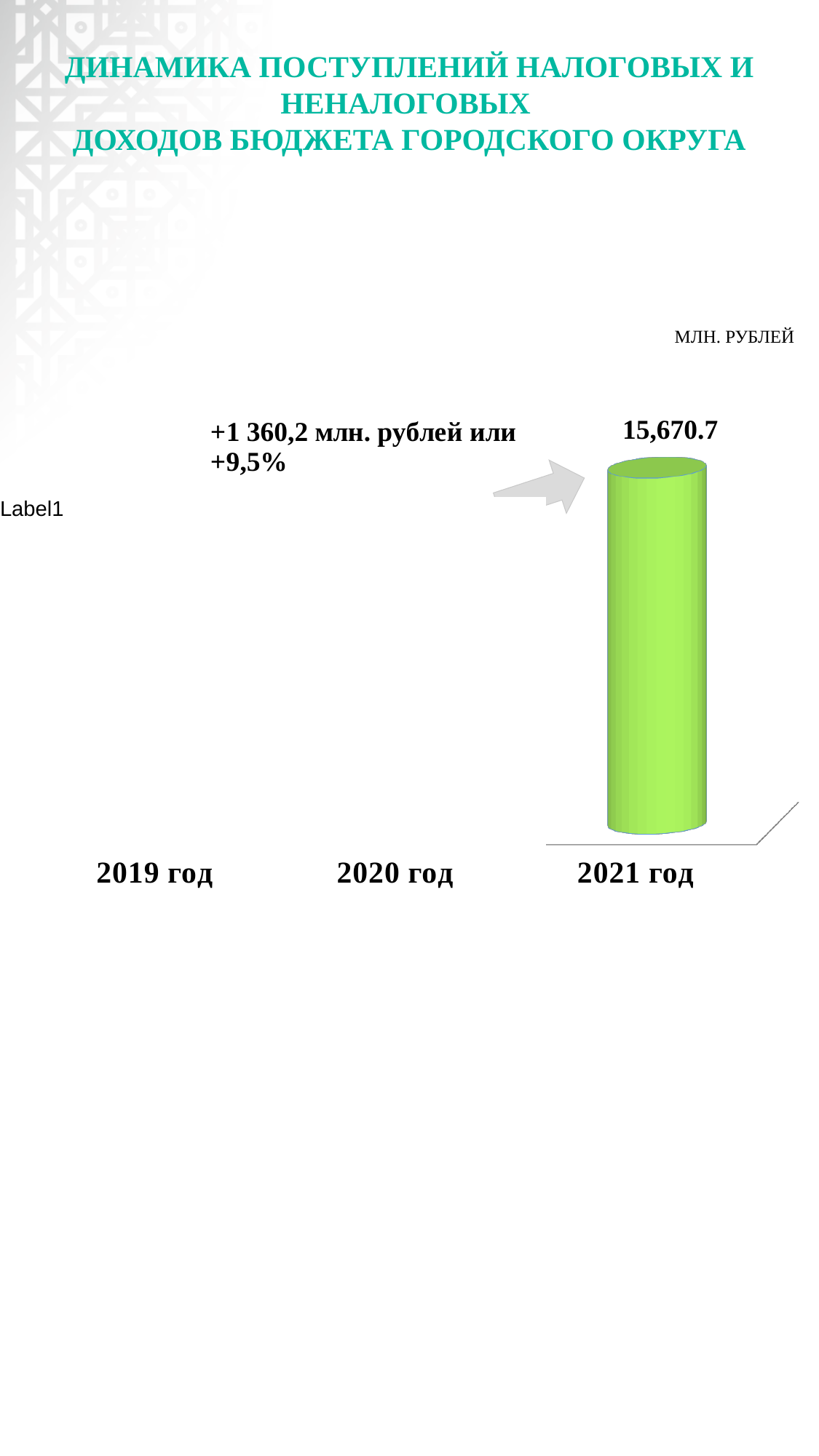
What kind of chart is shown on the slide? bar chart What is the value shown for 2021 год? 15,670.7 Which category on the x axis has a bar with the data label 15,670.7? 2021 год In what units are the chart values expressed, according to the label above the chart? МЛН. РУБЛЕЙ What increase is annotated next to the arrow pointing to the 2021 год bar? +1 360,2 млн. рублей или +9,5% How many categories are labelled along the x axis of the chart? 3